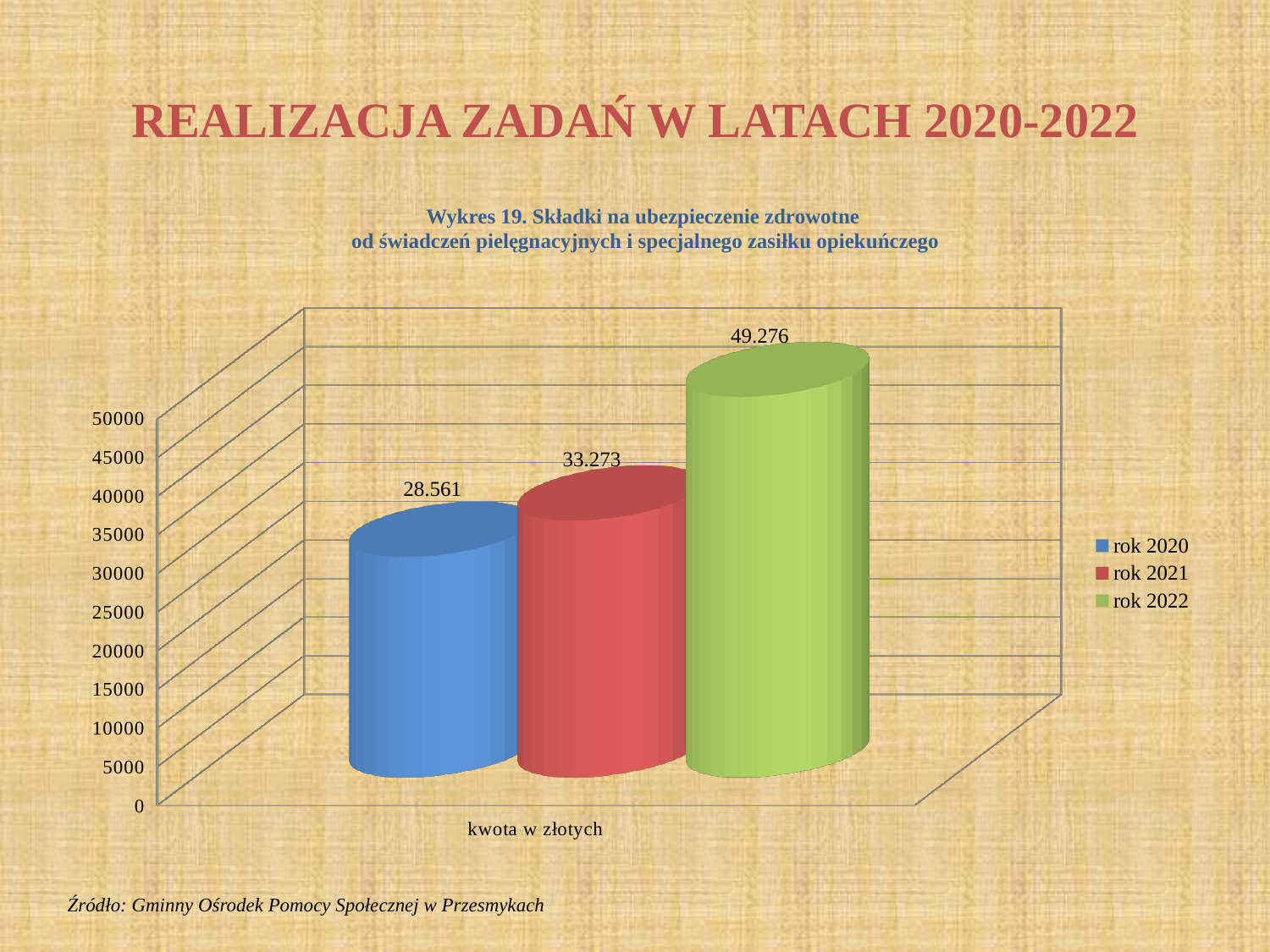
Which year has the highest value? rok 2022 What is the value for rok 2021? 33.273 What is the difference between the values for rok 2022 and rok 2020? 20.715 What is the label on the horizontal axis of the chart? kwota w złotych What is the value for rok 2022? 49.276 What is the difference between the values for rok 2021 and rok 2020? 4.712 What is the value for rok 2020? 28.561 Which year has the lowest value? rok 2020 What kind of chart is shown on the slide? bar chart How many series does the legend list? 3 Which is larger, the value for rok 2021 or the value for rok 2022? rok 2022 Is the value for rok 2022 greater or less than 45000? greater